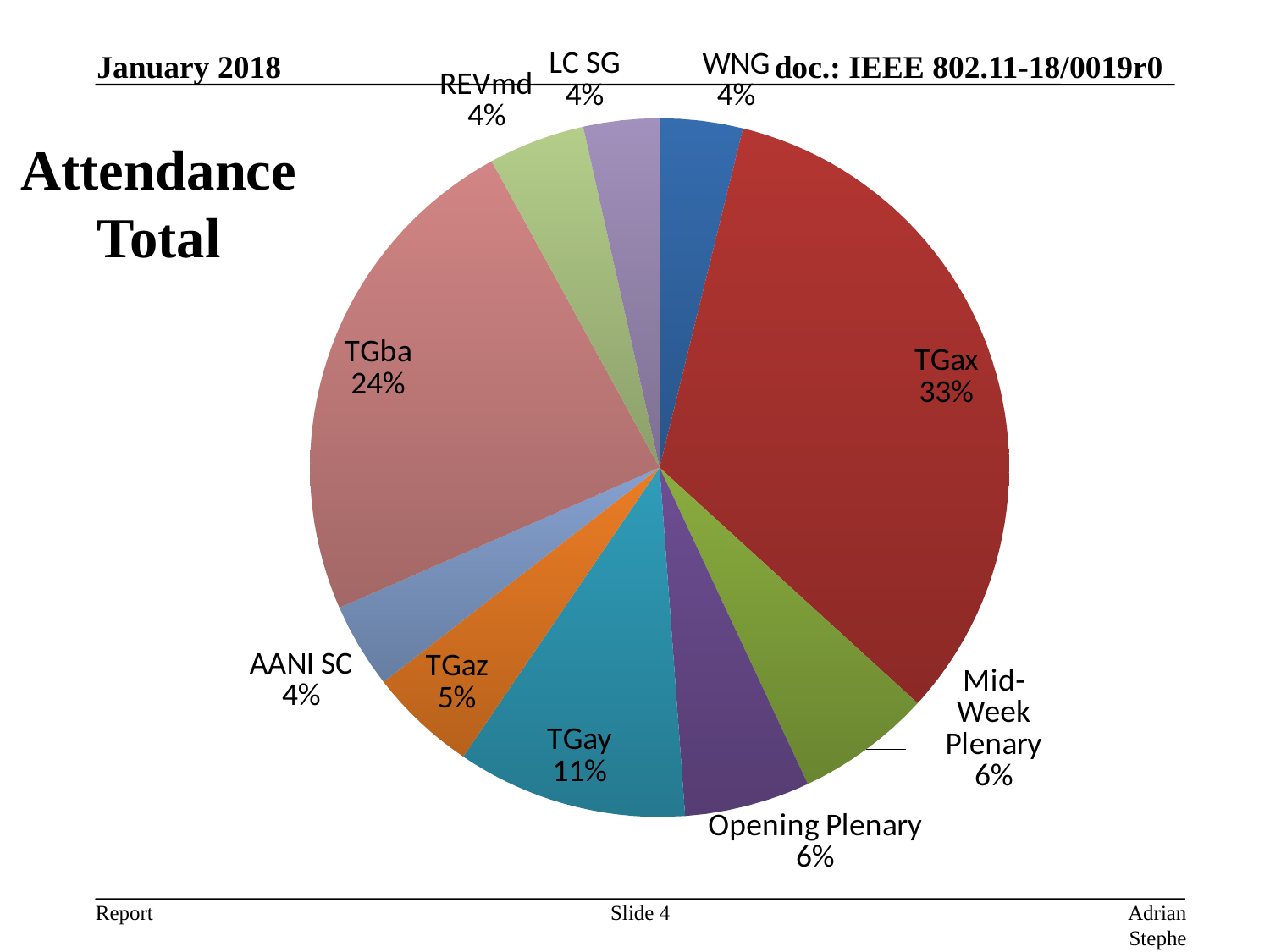
What share of attendance does TGax account for? 33% What kind of chart is shown on the slide? pie chart Which is larger, the share for TGba or the share for TGay? TGba What share of attendance does TGaz account for? 5% What is the difference in percentage points between the TGax share and the TGba share? 9 What share of attendance does the Mid-Week Plenary account for? 6% Which category has the largest slice of the pie? TGax What is the title of the chart? Attendance Total How many slices does the pie chart have? 10